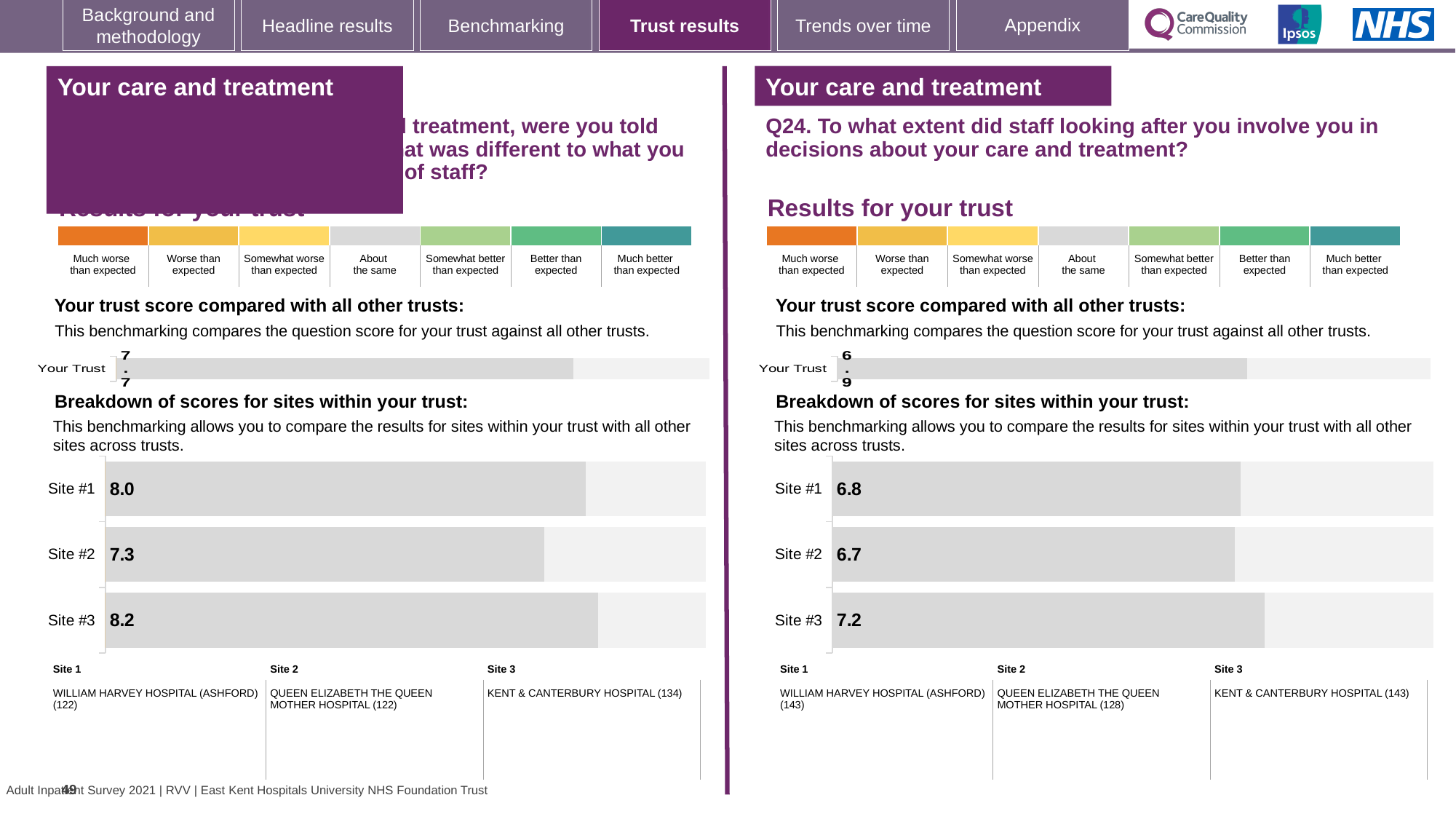
In the left-hand site breakdown chart, what is the score for Site #1? 8.0 Which is larger: the Site #1 score in the left-hand site breakdown chart or the Site #1 score in the right-hand (Q24) site breakdown chart? Left-hand chart (8.0) In the right-hand (Q24) site breakdown chart, which site has the highest score? Site #3 In the right-hand (Q24) 'Your trust score compared with all other trusts' chart, what is the score for Your Trust? 6.9 In the left-hand site breakdown chart, which site has the highest score? Site #3 What type of chart is the left-hand site breakdown chart? Bar chart In the right-hand (Q24) site breakdown chart, what is the score for Site #2? 6.7 In the left-hand 'Your trust score compared with all other trusts' chart, what is the score for Your Trust? 7.7 In the left-hand site breakdown chart, what is the difference between the scores for Site #3 and Site #2? 0.9 In the right-hand (Q24) site breakdown chart, what is the difference between the scores for Site #3 and Site #1? 0.4 How many sites are shown in the right-hand (Q24) site breakdown chart? 3 In the left-hand site breakdown chart, which site has the lowest score? Site #2